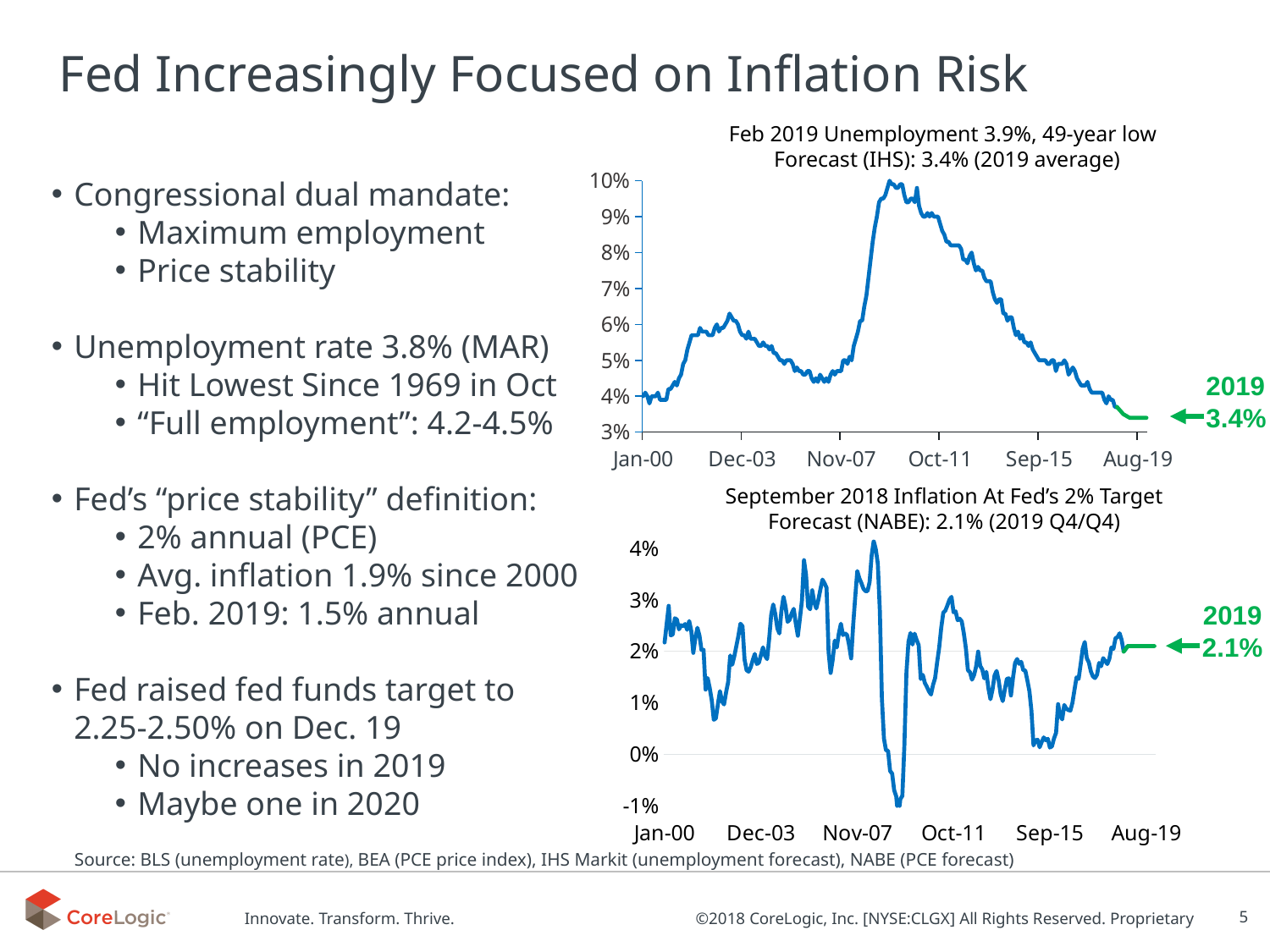
How many x-axis tick labels are shown on the bottom inflation chart? 6 Which labelled 2019 forecast value is larger: the unemployment forecast in the top chart or the inflation forecast in the bottom chart? unemployment forecast (3.4%) In the top unemployment chart, is the value at Jan-00 greater or less than 5%? less In the bottom inflation chart, what colour is the 2019 forecast segment at the right end of the line? green In the top unemployment chart, what is the labelled 2019 forecast value? 3.4% What kind of chart is the bottom chart on the slide (the inflation chart)? line chart In the top unemployment chart, does the line rise or fall between Oct-11 and Aug-19? fall What is the first line of the title of the top chart? Feb 2019 Unemployment 3.9%, 49-year low In the top unemployment chart, is the peak value reached around 2009-2010 greater or less than 9%? greater In the bottom inflation chart, is the lowest value reached around 2009 greater or less than 0%? less In the bottom inflation chart, what is the labelled 2019 forecast value? 2.1% What kind of chart is the top chart on the slide (the unemployment chart)? line chart